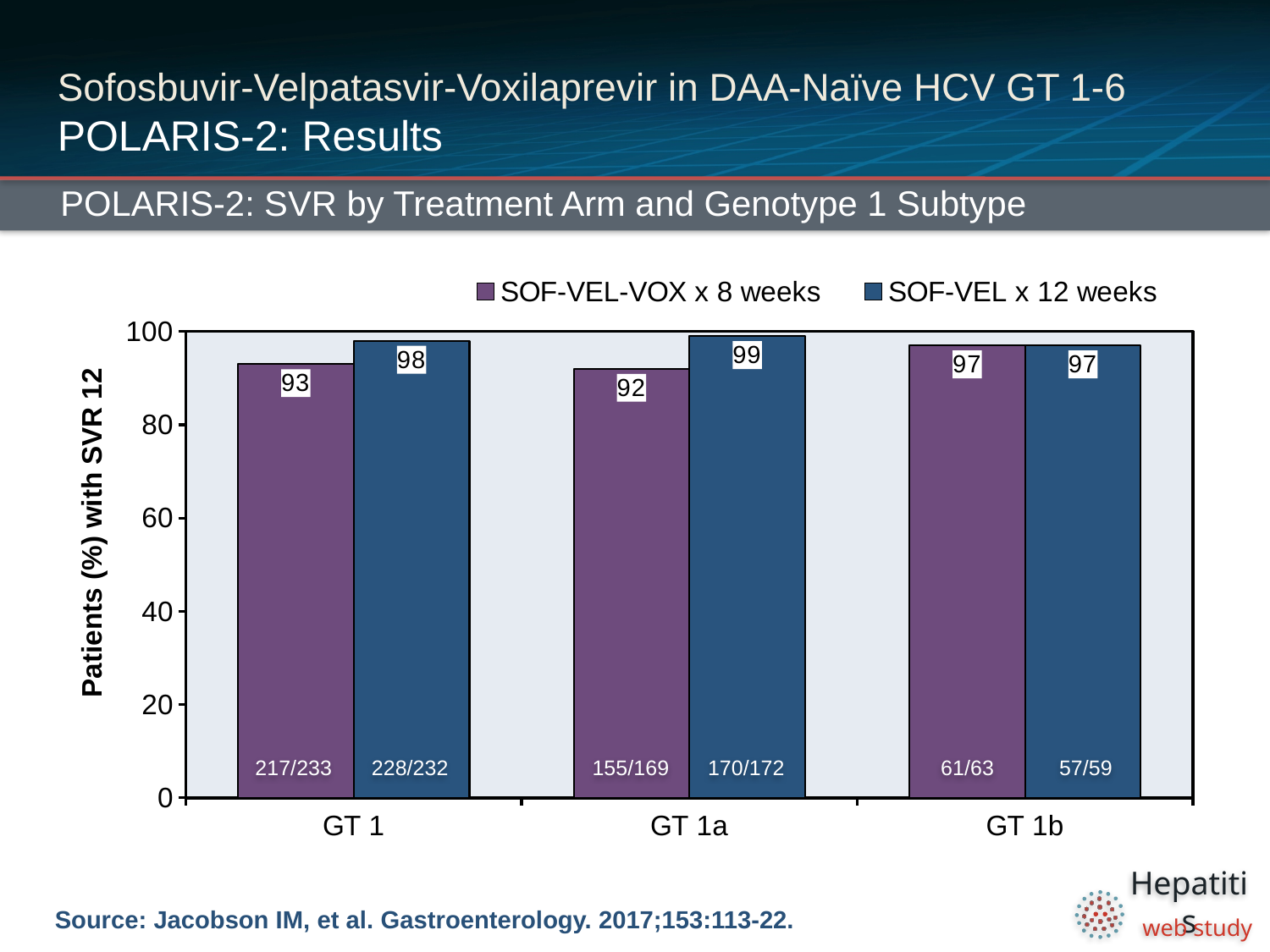
Which genotype subtype has the highest value for SOF-VEL x 12 weeks? GT 1a What kind of chart is shown on the slide? Bar chart What is the SVR 12 value for SOF-VEL-VOX x 8 weeks in GT 1? 93 Which genotype subtype has the lowest value for SOF-VEL-VOX x 8 weeks? GT 1a What is the SVR 12 value for SOF-VEL-VOX x 8 weeks in GT 1b? 97 What is the label of the y axis? Patients (%) with SVR 12 In GT 1, which treatment arm has the higher SVR 12 value? SOF-VEL x 12 weeks How many series does the legend list? 2 What is the difference between the SOF-VEL x 12 weeks and SOF-VEL-VOX x 8 weeks values in GT 1a? 7 How many genotype categories are shown on the x axis? 3 What is the SVR 12 value for SOF-VEL x 12 weeks in GT 1a? 99 What fraction of patients is shown for SOF-VEL x 12 weeks in GT 1? 228/232